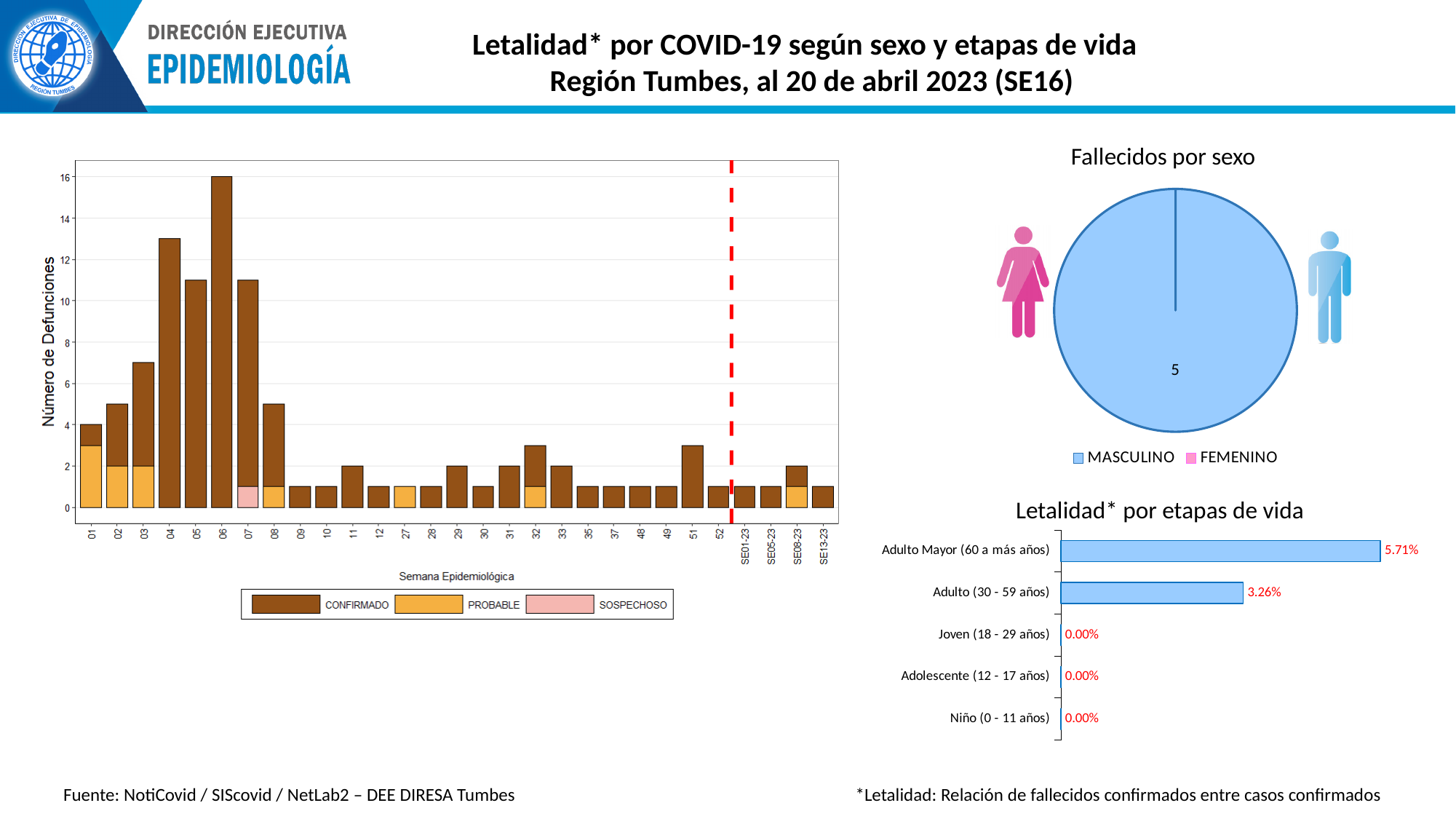
In the 'Letalidad* por etapas de vida' chart, what is the value for Joven (18 - 29 años)? 0.00% In the 'Letalidad* por etapas de vida' chart, what is the difference between the values for Adulto Mayor (60 a más años) and Adulto (30 - 59 años)? 2.45% In the 'Fallecidos por sexo' pie chart, which sex accounts for the larger share of deaths? MASCULINO In the 'Fallecidos por sexo' pie chart, how many entries does the legend list? 2 In the 'Letalidad* por etapas de vida' chart, what is the value for Adulto (30 - 59 años)? 3.26% In the left chart of deaths by epidemiological week, what is the number of deaths in week 06? 16 In the left chart of deaths by epidemiological week, which week has the highest number of deaths? 06 In the 'Letalidad* por etapas de vida' chart, what is the value for Adulto Mayor (60 a más años)? 5.71% In the left chart of deaths by epidemiological week, how many series does the legend list? 3 In the 'Letalidad* por etapas de vida' chart, how many age groups are shown? 5 In the 'Letalidad* por etapas de vida' chart, which age group has the highest lethality? Adulto Mayor (60 a más años) In the left chart of deaths by epidemiological week, is the value for week 04 greater or less than 12? greater